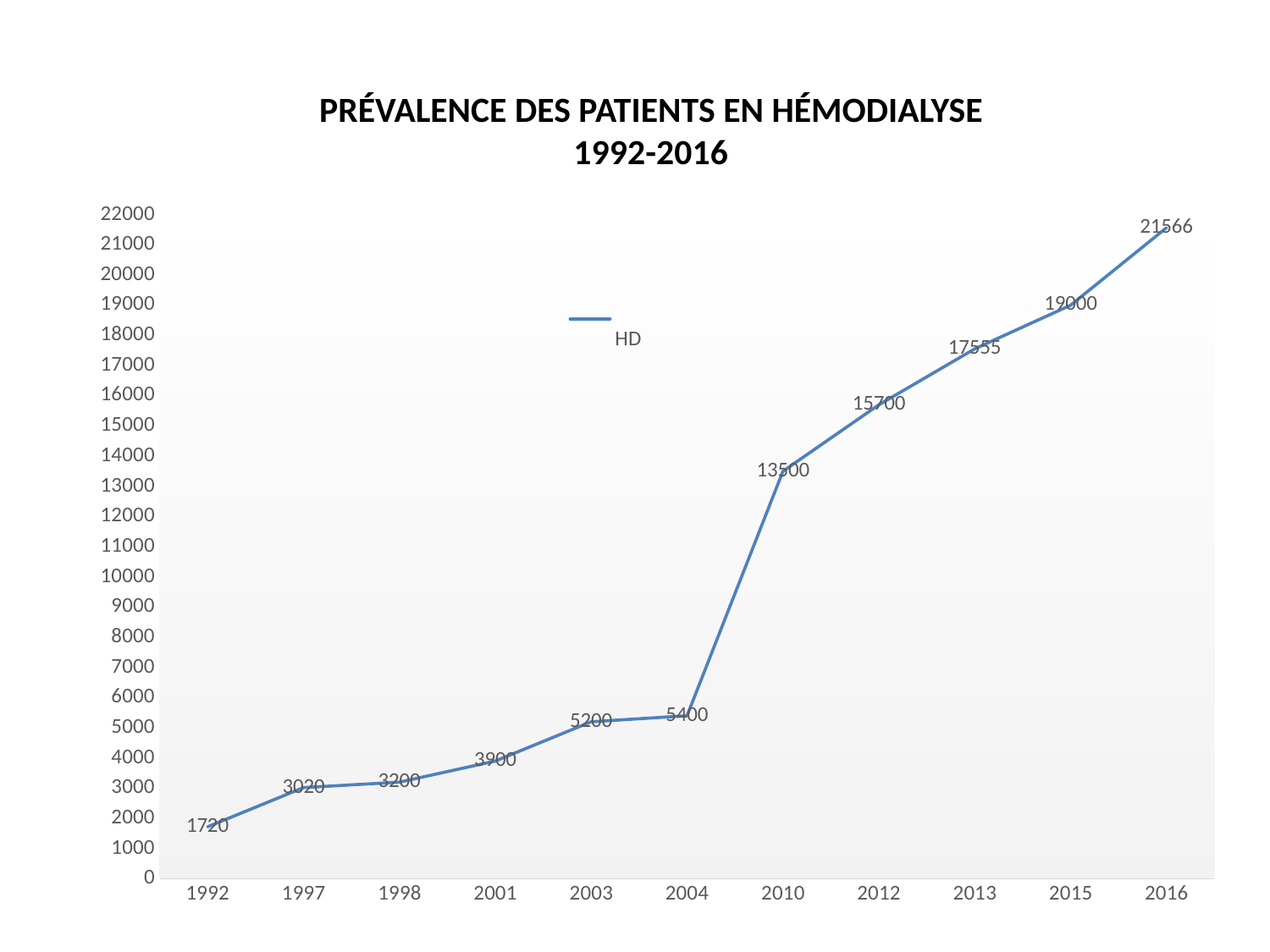
How many series does the legend list? 1 Which year has the lowest value? 1992 What is the difference between the values for 2010 and 2004? 8100 What is the value for 1992? 1720 What is the value for 2010? 13500 Which year has the highest value? 2016 What is the value for 2013? 17555 What kind of chart is this? line chart How many years are plotted on the x axis? 11 Which is larger, the value for 2003 or the value for 2004? 2004 What is the difference between the values for 2016 and 2015? 2566 Do the values rise or fall from 1992 to 2016? rise